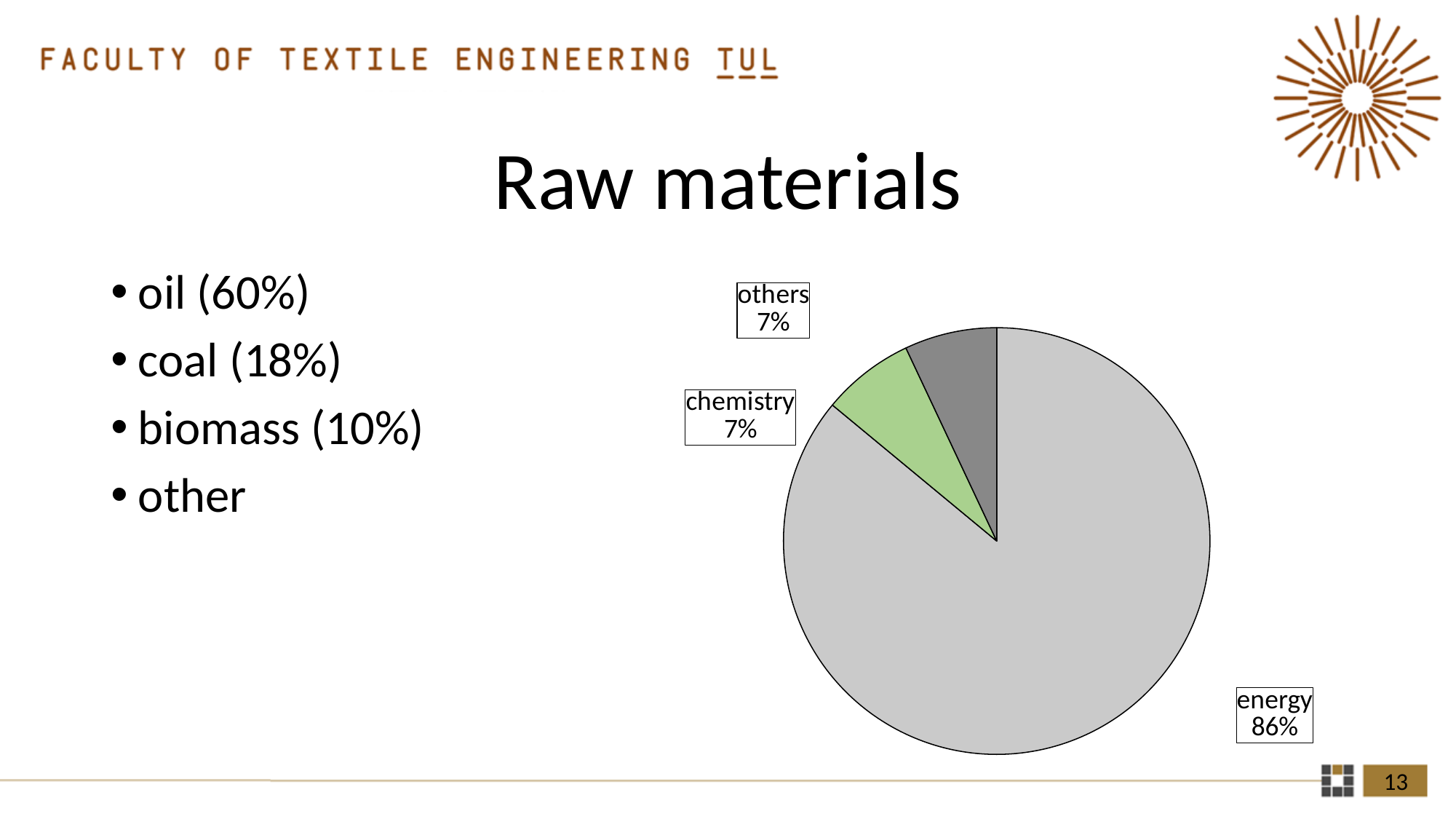
What is the combined share of the chemistry and others slices? 14% What share of the pie does energy account for? 86% What share of the pie does chemistry account for? 7% How many slices does the pie chart have? 3 What colour is the chemistry slice of the pie chart? green What share of the pie does others account for? 7% Is the value for energy greater or less than 50%? greater Which slice of the pie chart is the largest? energy What is the title of the slide containing the pie chart? Raw materials What kind of chart is shown on the slide? pie chart What is the difference in percentage points between the energy slice and the chemistry slice? 79 Which is larger, the energy slice or the others slice? energy